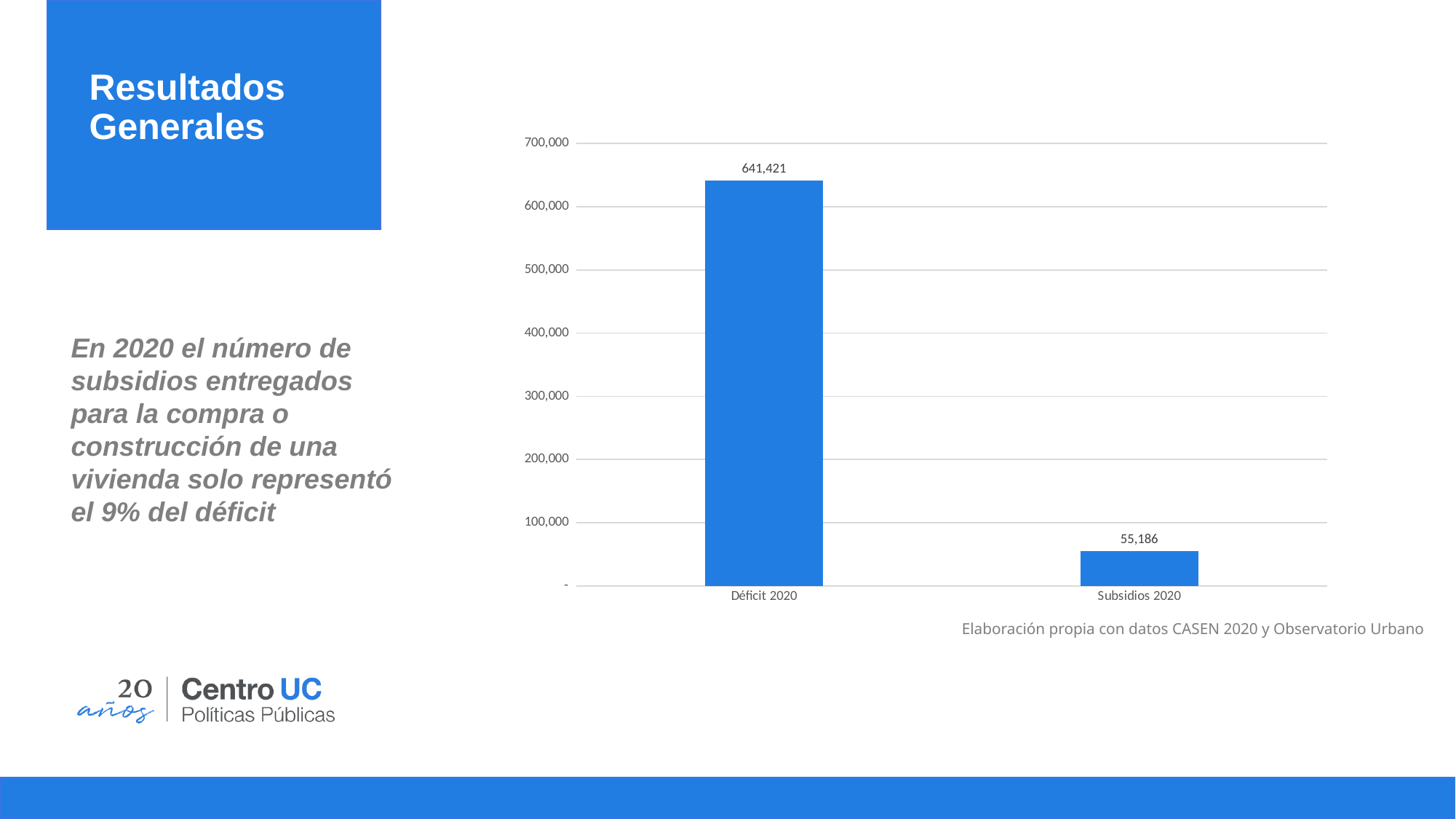
How many categories are shown on the x axis? 2 What is the value for Déficit 2020? 641,421 Is the value for Subsidios 2020 greater or less than 100,000? less Which category has the lowest value? Subsidios 2020 What is the highest value shown on the y axis? 700,000 Which category has the highest value? Déficit 2020 What is the difference between the values for Déficit 2020 and Subsidios 2020? 586,235 What is the value for Subsidios 2020? 55,186 Is the value for Déficit 2020 greater or less than 600,000? greater What kind of chart is shown on the slide? bar chart Which is larger, the value for Déficit 2020 or the value for Subsidios 2020? Déficit 2020 What colour are the bars in the chart? blue